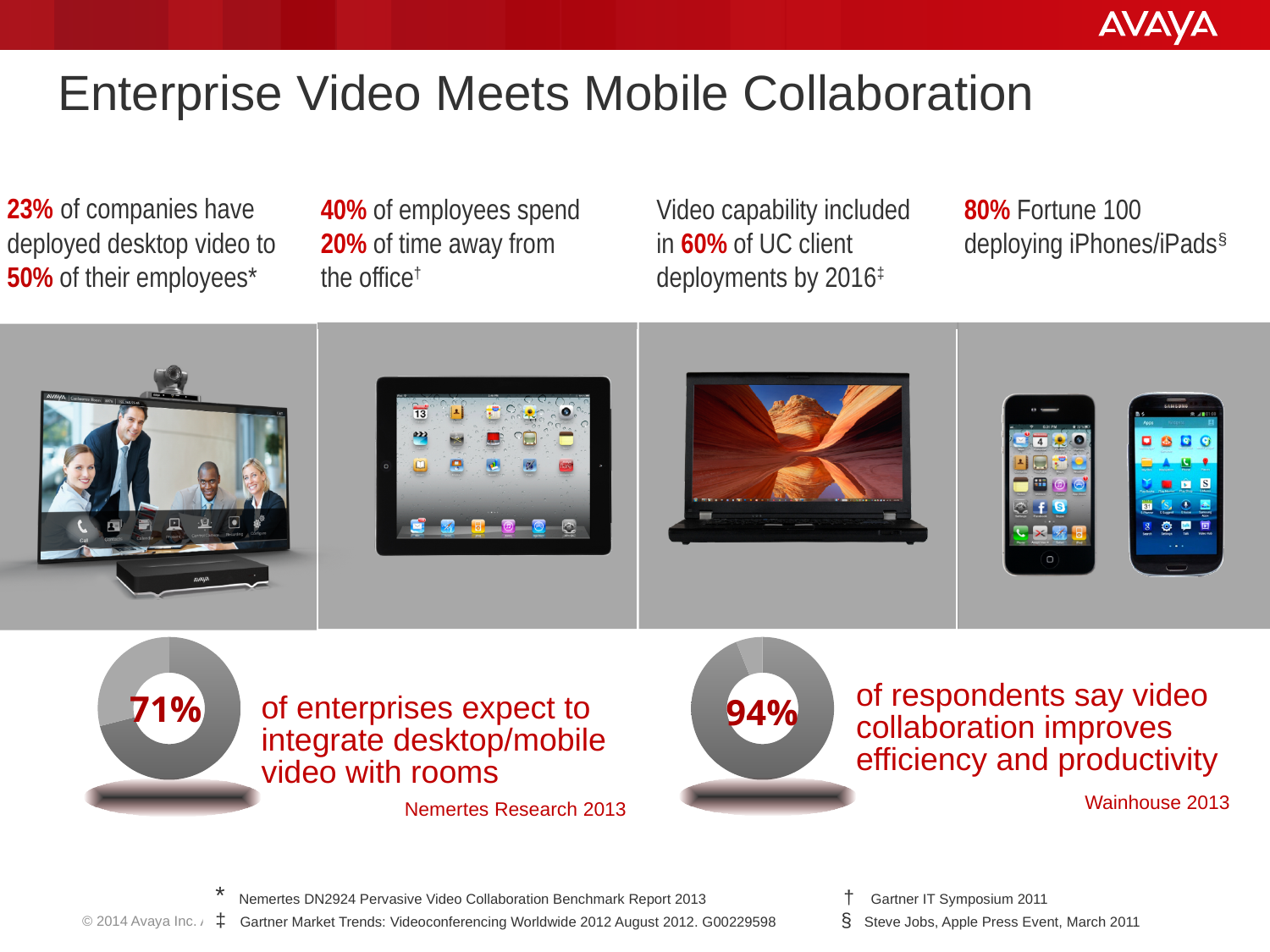
In the left donut chart, what share of the ring is represented by the highlighted segment? 71% Which donut chart shows the larger percentage, the left one (enterprises integrating desktop/mobile video with rooms) or the right one (video collaboration improves efficiency and productivity)? The right one (94%) In the right donut chart, what percentage of respondents say video collaboration improves efficiency and productivity? 94% In the left donut chart, what percentage of enterprises expect to integrate desktop/mobile video with rooms? 71% What source is cited beneath the left donut chart (71%)? Nemertes Research 2013 What is the difference in percentage points between the right donut chart's value (94%) and the left donut chart's value (71%)? 23 percentage points What kind of chart is used to show the 71% statistic on the left of the slide? Donut (pie) chart What source is cited beneath the right donut chart (94%)? Wainhouse 2013 In the right donut chart, what share of the ring is not covered by the 94% segment? 6% How many donut charts are shown on the slide? 2